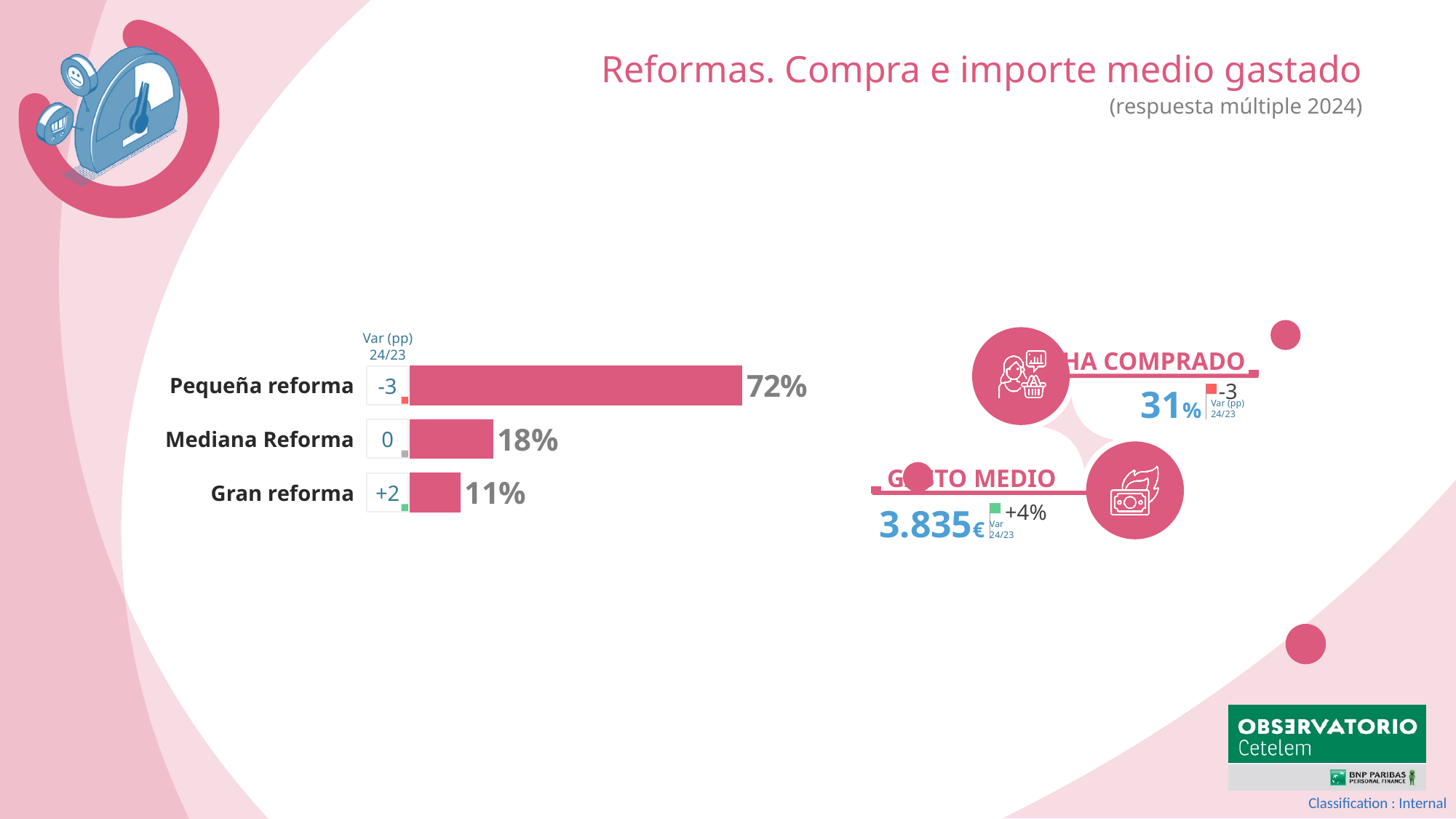
What kind of chart is shown on the slide? Bar chart Which category has the lowest value? Gran reforma Which category has the highest value? Pequeña reforma Which is larger, the value for Mediana Reforma or Gran reforma? Mediana Reforma What is the difference between the values for Pequeña reforma and Mediana Reforma? 54 percentage points What is the value for Gran reforma? 11% What is the Var (pp) 24/23 shown for Pequeña reforma? -3 What is the Var (pp) 24/23 shown for Gran reforma? +2 What is the title of the slide? Reformas. Compra e importe medio gastado What is the value for Mediana Reforma? 18% How many categories does the bar chart show? 3 What is the value for Pequeña reforma? 72%